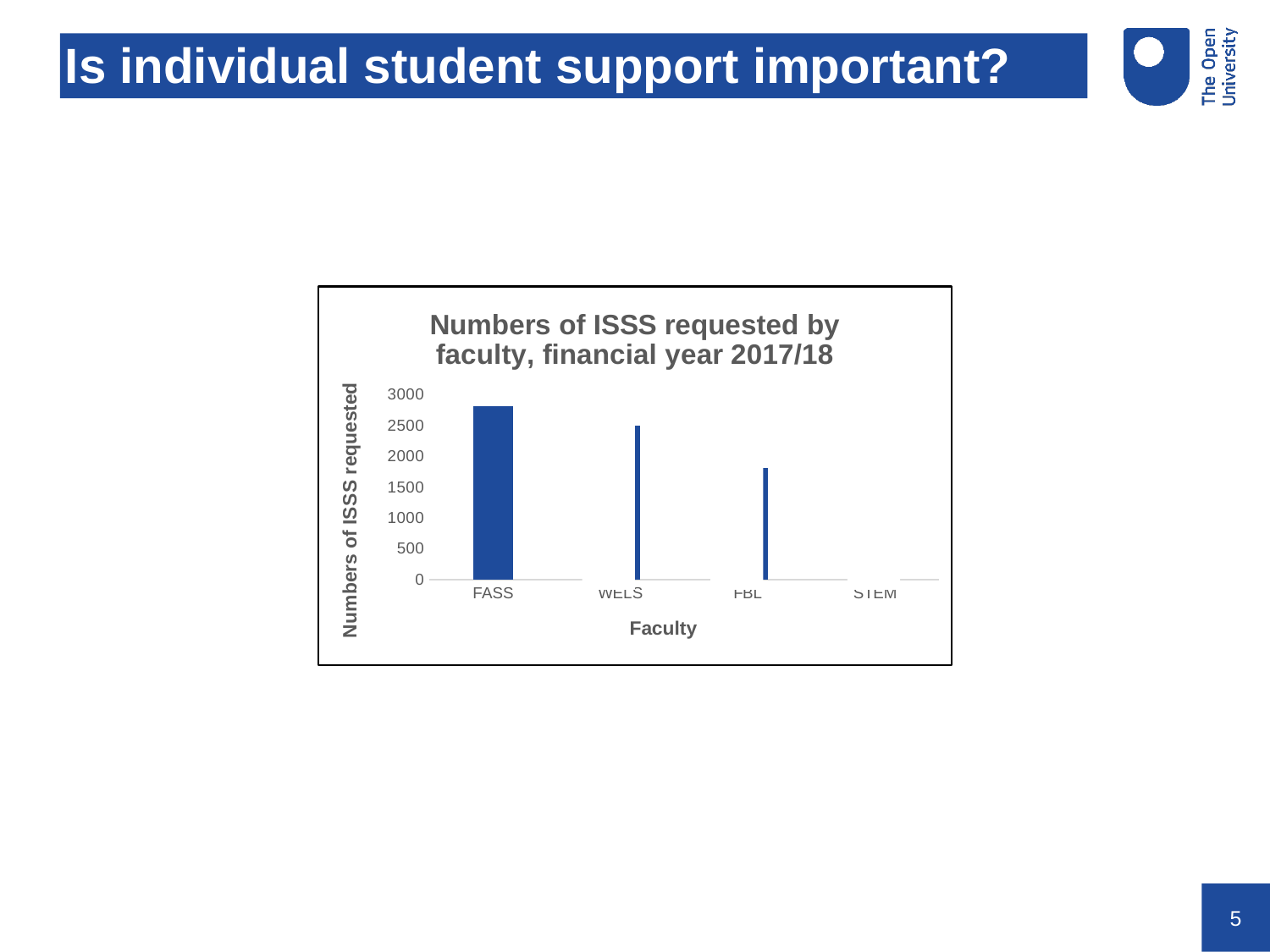
Which faculty has the highest number of ISSS requested? FASS How many faculties are shown on the x axis of the chart? 4 Is the value for FASS greater or less than 2500? greater What is the label on the y axis of the chart? Numbers of ISSS requested Is the value for FBL greater or less than 2000? less Is the value for WELS greater or less than 2000? greater What kind of chart is shown on the slide? bar chart What is the title of the chart? Numbers of ISSS requested by faculty, financial year 2017/18 Which faculty has more ISSS requested, WELS or FBL? WELS Do the values rise or fall moving from FASS to STEM along the x axis? fall Which faculty has more ISSS requested, FASS or FBL? FASS Which faculty has the lowest number of ISSS requested? STEM